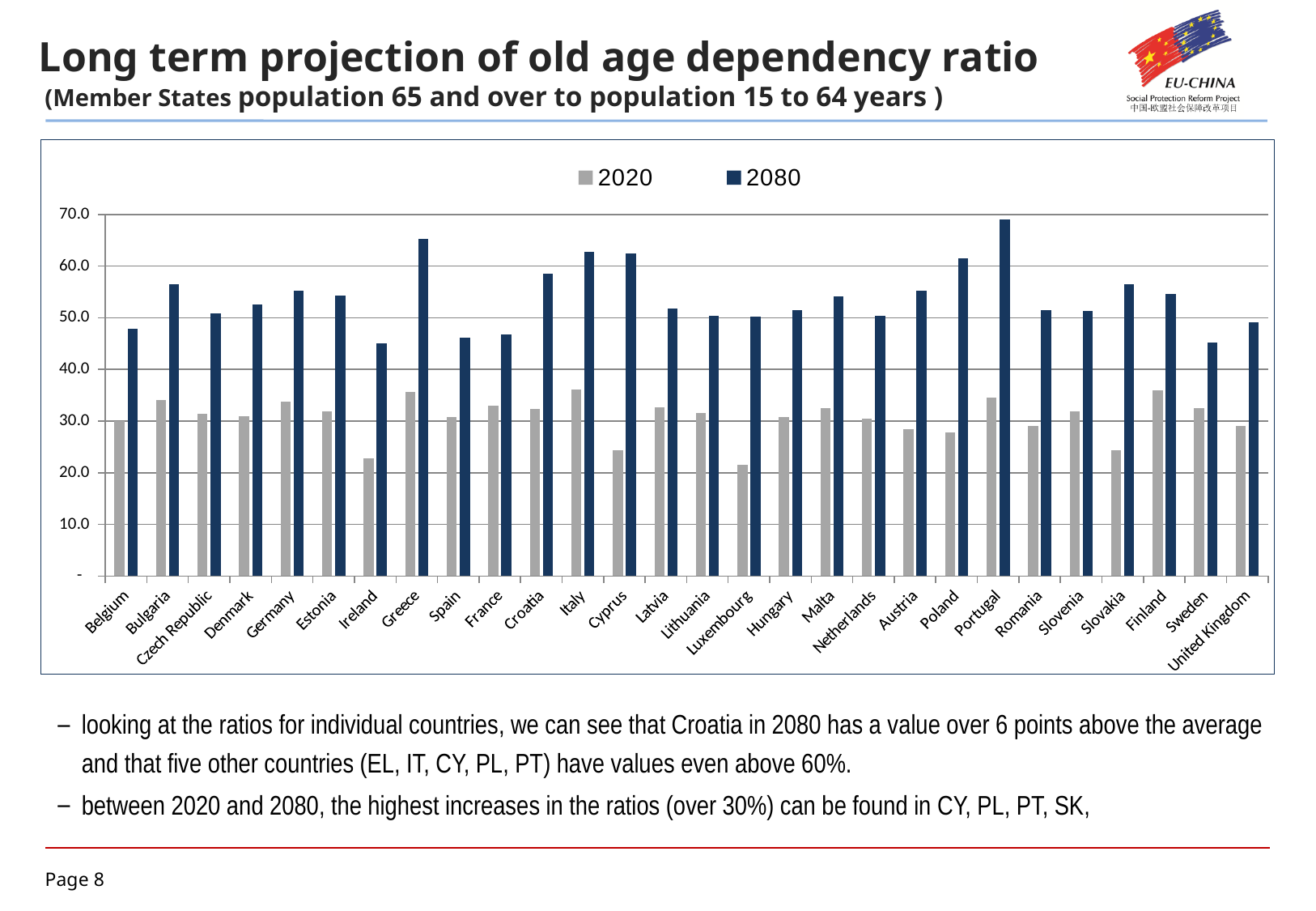
Is the 2020 value for Ireland greater or less than 30? less Which is larger, the 2080 value for Greece or the 2080 value for Spain? Greece Is the 2080 value for Belgium greater or less than 50? less How many countries are shown on the x axis? 28 Is the 2020 value for Luxembourg greater or less than 30? less Which country has the highest 2080 value? Portugal What kind of chart is shown on the slide? bar chart Which is larger, the 2020 value for Cyprus or the 2020 value for Latvia? Latvia How many series does the legend list? 2 Which series is shown in dark blue in the legend? 2080